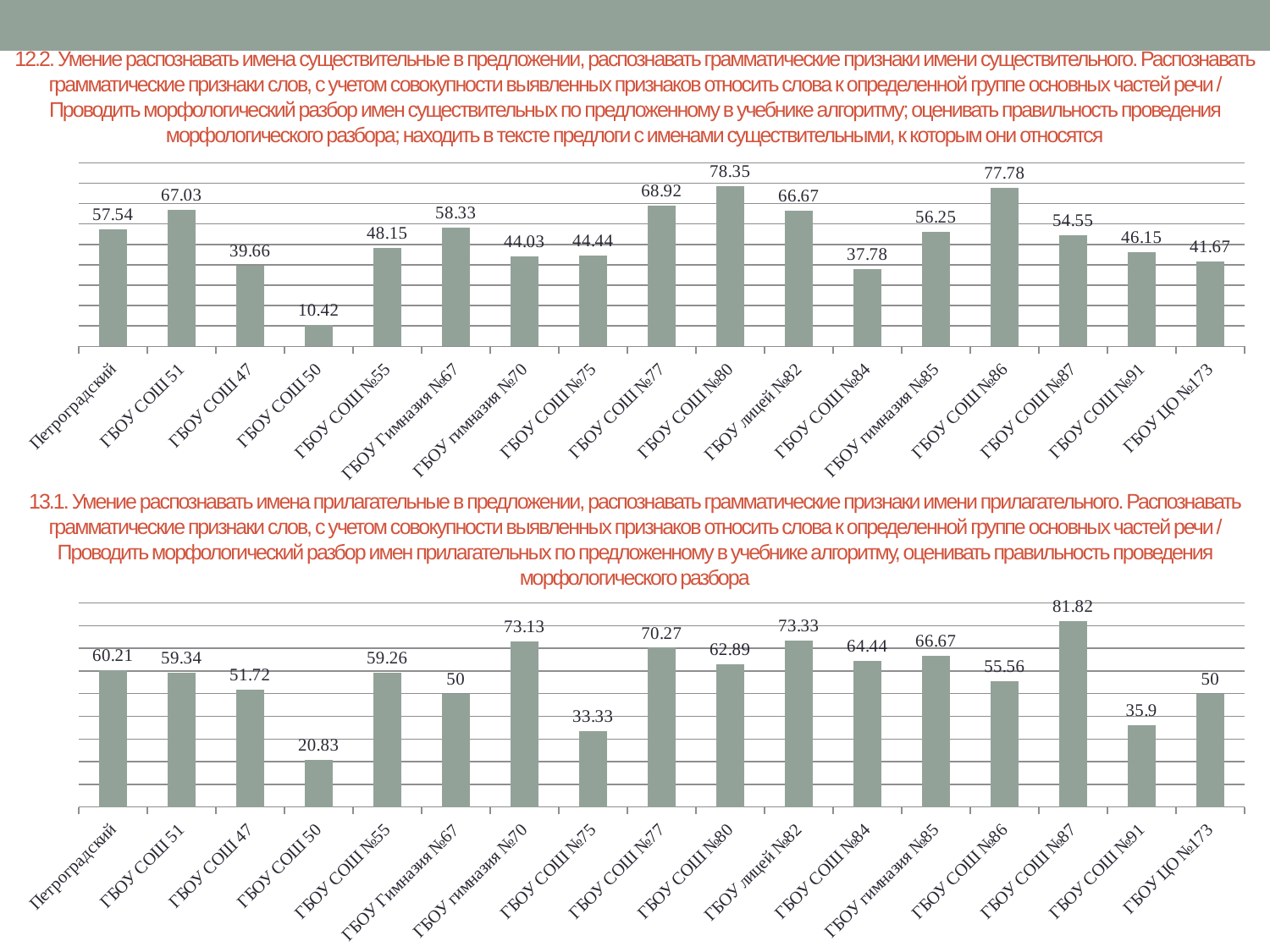
In the bottom chart (13.1), which category has the highest value? ГБОУ СОШ №87 In the top chart (12.2), what is the value for ГБОУ СОШ 50? 10.42 In the top chart (12.2), what is the difference between the values for ГБОУ СОШ 51 and ГБОУ СОШ 47? 27.37 In the bottom chart (13.1), what is the value for ГБОУ СОШ №91? 35.9 In the bottom chart (13.1), how many categories are shown on the x axis? 17 In the top chart (12.2), which is larger: the value for ГБОУ СОШ №77 or ГБОУ лицей №82? ГБОУ СОШ №77 In the top chart (12.2), what is the value for ГБОУ СОШ №86? 77.78 What type of chart is the bottom chart (13.1)? Bar chart In the bottom chart (13.1), what is the value for ГБОУ гимназия №70? 73.13 In the top chart (12.2), which category has the lowest value? ГБОУ СОШ 50 In the top chart (12.2), which category has the highest value? ГБОУ СОШ №80 In the bottom chart (13.1), which category has the lowest value? ГБОУ СОШ 50